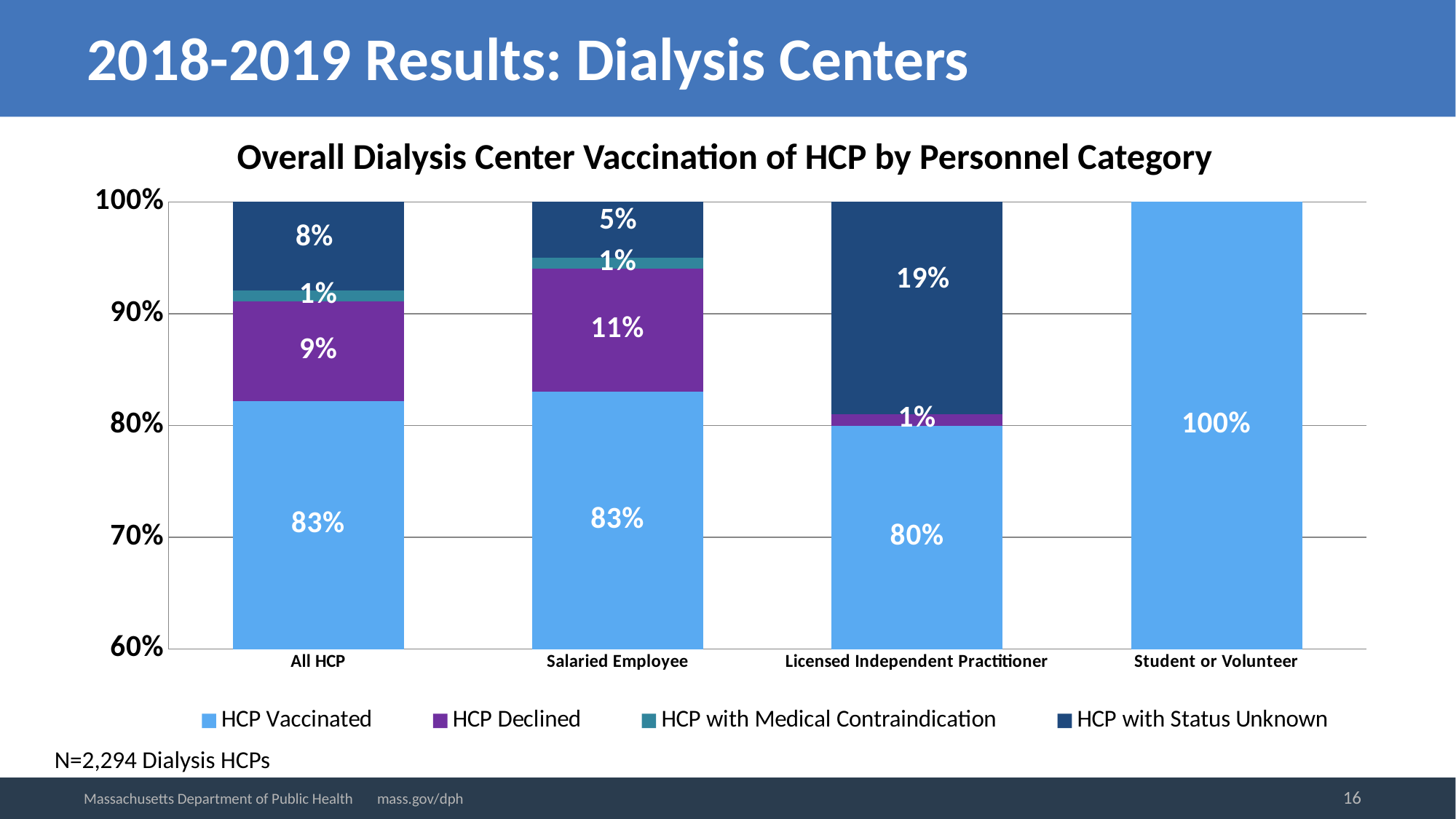
What kind of chart is shown on the slide? Stacked bar chart How many series does the legend list? 4 What is the HCP Vaccinated value for Student or Volunteer? 100% What percentage of Salaried Employees declined vaccination? 11% Which personnel category has the lowest HCP Vaccinated percentage? Licensed Independent Practitioner How many personnel categories are shown on the x axis? 4 What is the difference in HCP with Status Unknown between Licensed Independent Practitioner and All HCP? 11 percentage points Which has a larger HCP Declined percentage, All HCP or Salaried Employee? Salaried Employee What is the HCP with Status Unknown value for Licensed Independent Practitioner? 19% What is the title of the chart? Overall Dialysis Center Vaccination of HCP by Personnel Category Which personnel category has the highest HCP Vaccinated percentage? Student or Volunteer What percentage of HCP were vaccinated in the All HCP category? 83%